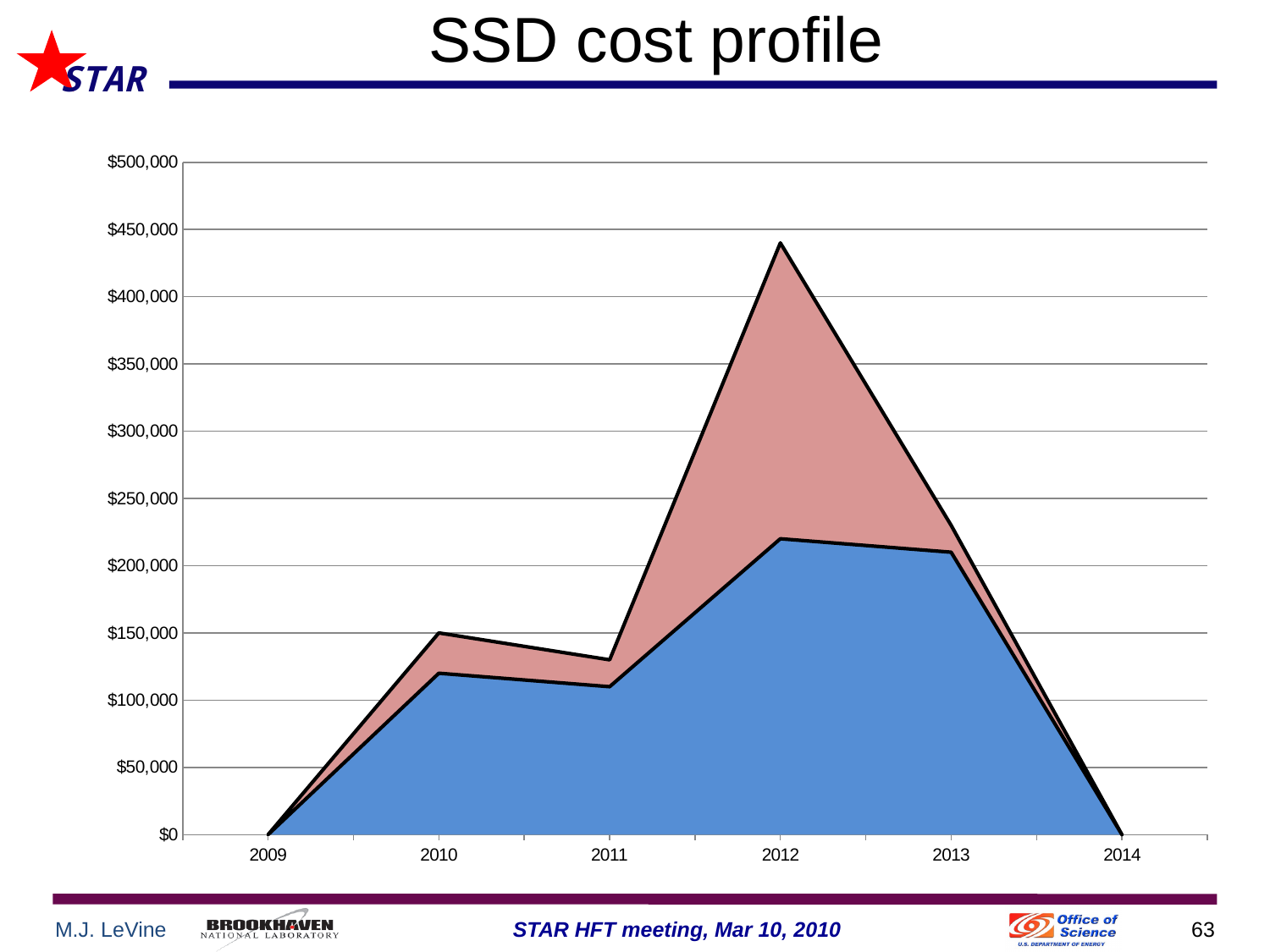
Do the total values rise or fall from 2012 to 2014? fall Is the total value for 2012 greater or less than $400,000? greater In which year does the chart reach its highest total value? 2012 Is the value of the blue (lower) area for 2013 greater or less than $200,000? greater What is the total value shown for 2009? $0 How many years are shown on the x axis of the chart? 6 What is the total value shown for 2014? $0 Is the value of the blue (lower) area for 2010 greater or less than $100,000? greater Which year has the larger total value, 2012 or 2013? 2012 What kind of chart is shown on the slide? Area chart What is the title of the chart? SSD cost profile